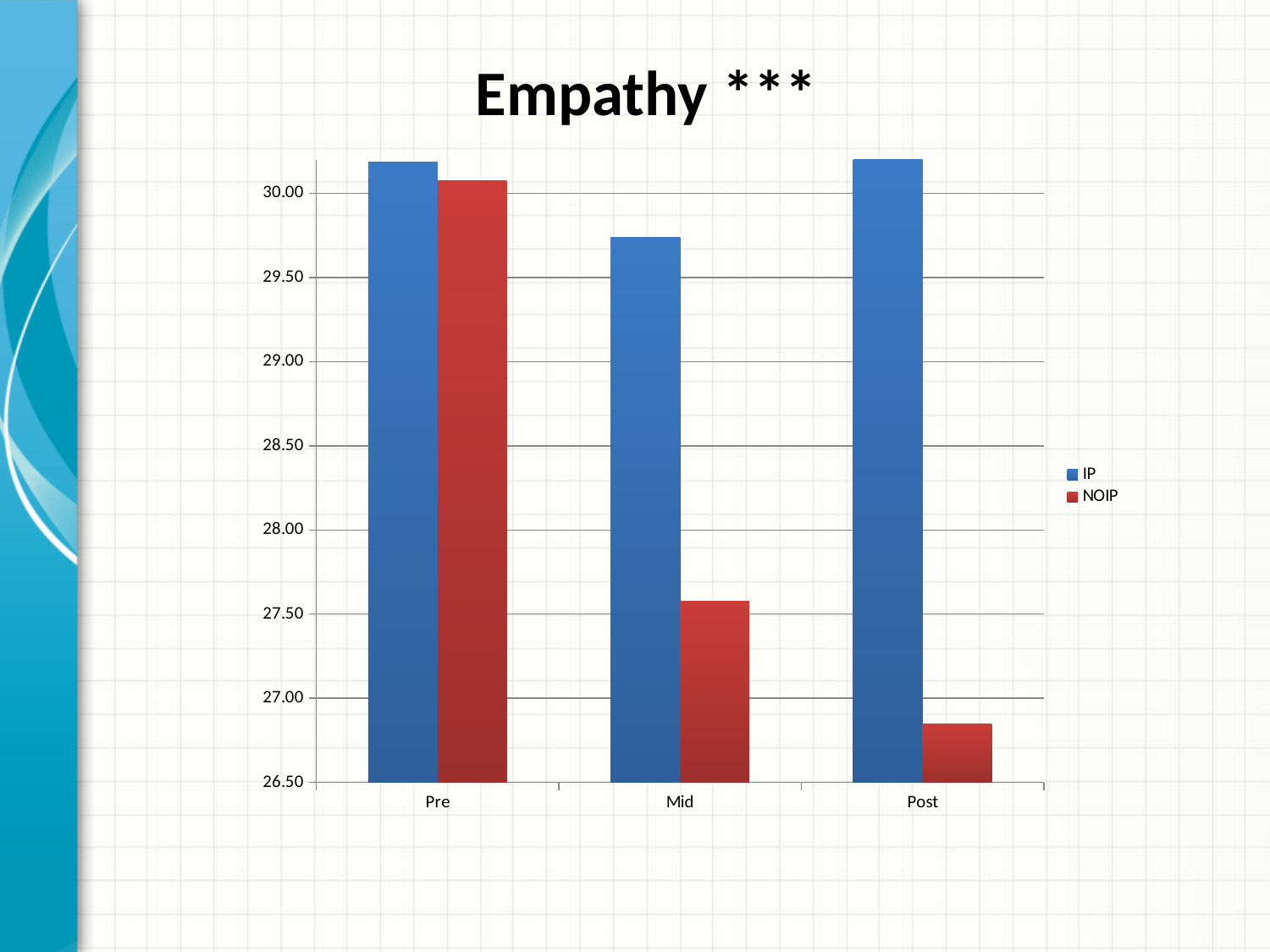
Which series is shown in red? NOIP Which category has the lowest NOIP value? Post Is the NOIP value for Post greater or less than 27.00? less Which category has the lowest IP value? Mid Do the NOIP values rise or fall from Pre to Post? fall What kind of chart is shown on the slide? bar chart Is the NOIP value for Mid greater or less than 28.00? less How many categories are shown on the x axis? 3 Is the IP value for Mid greater or less than 29.50? greater How many series does the legend list? 2 What is the title of the chart? Empathy ***